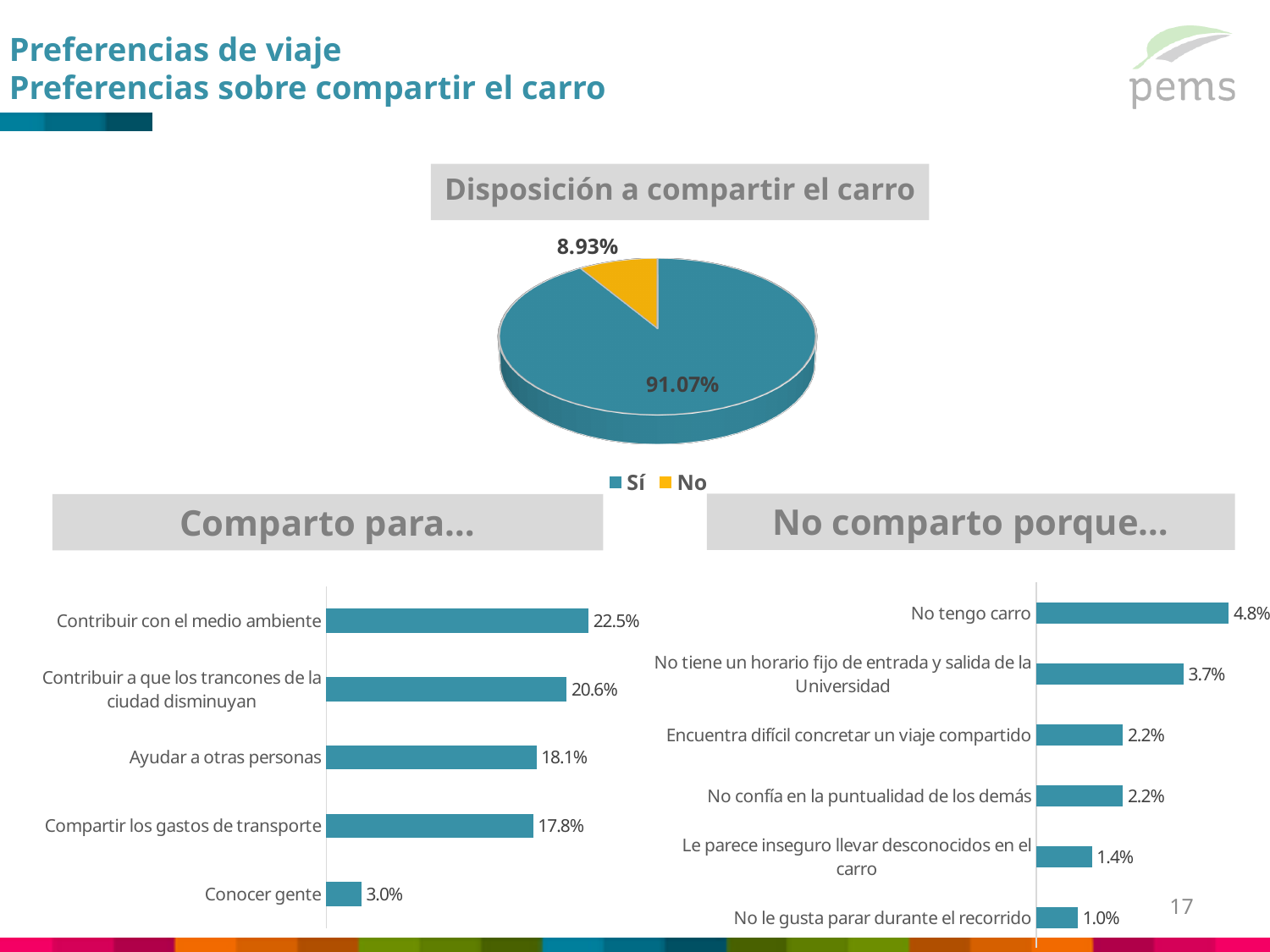
In the 'Disposición a compartir el carro' pie chart, what share of respondents answered 'Sí'? 91.07% In the 'Comparto para...' chart, which category has the lowest value? Conocer gente How many categories are shown in the 'Comparto para...' chart? 5 In the 'Comparto para...' chart, what is the difference between 'Contribuir con el medio ambiente' and 'Contribuir a que los trancones de la ciudad disminuyan'? 1.9% How many series does the legend of the 'Disposición a compartir el carro' chart list? 2 What kind of chart is 'Disposición a compartir el carro'? Pie chart How many categories are shown in the 'No comparto porque...' chart? 6 In the 'No comparto porque...' chart, which category has the highest value? No tengo carro In the 'Comparto para...' chart, which is larger: 'Ayudar a otras personas' or 'Compartir los gastos de transporte'? Ayudar a otras personas In the 'Comparto para...' chart, what is the value for 'Contribuir con el medio ambiente'? 22.5% In the 'No comparto porque...' chart, what is the value for 'Le parece inseguro llevar desconocidos en el carro'? 1.4% In the 'Disposición a compartir el carro' pie chart, what share of respondents answered 'No'? 8.93%